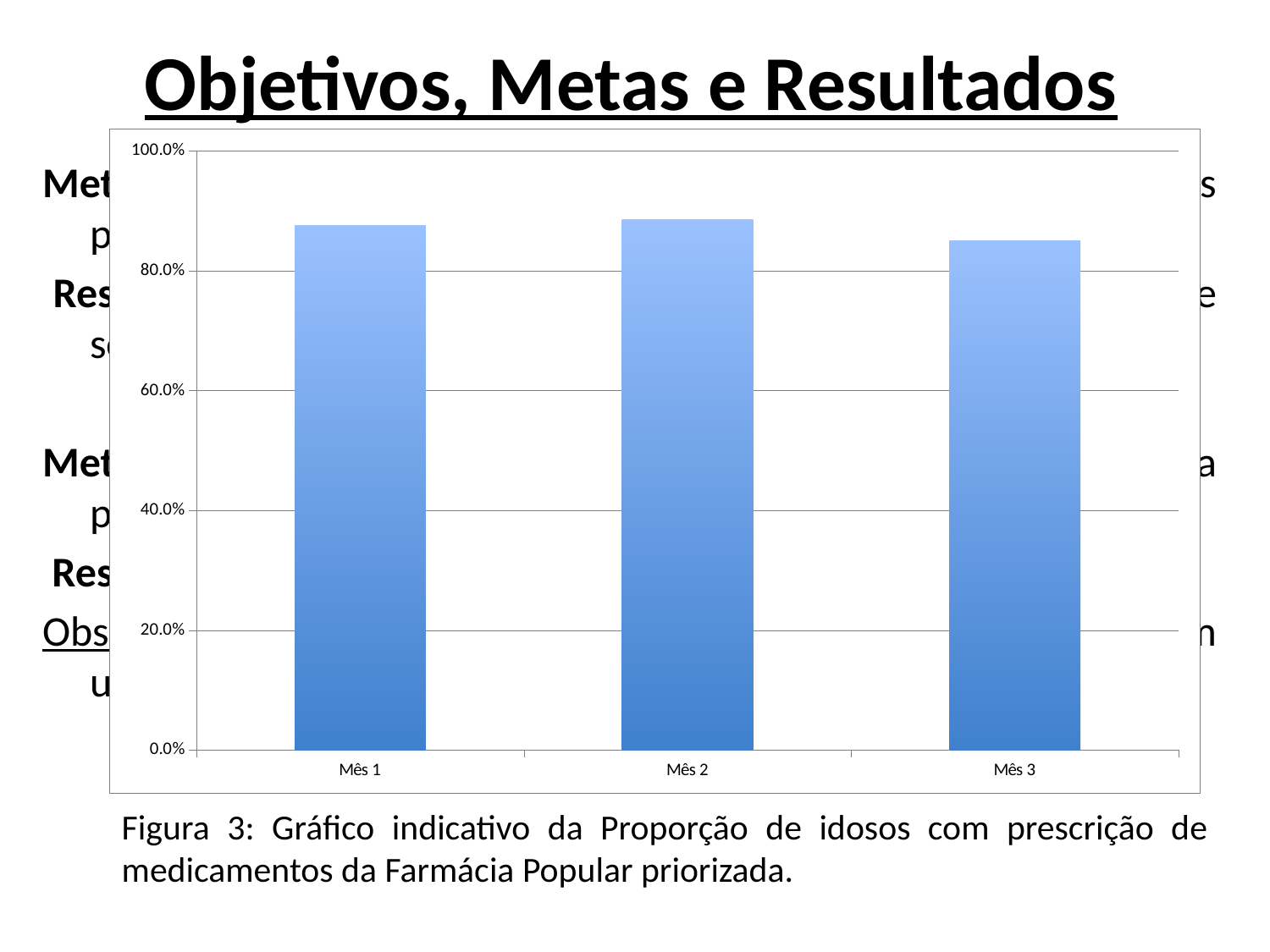
Is the value for Mês 2 greater or less than 100.0%? less How many categories (months) are plotted on the chart? 3 Which is larger, the value for Mês 2 or the value for Mês 3? Mês 2 What is the highest value shown on the y axis of the chart? 100.0% Is the value for Mês 2 greater or less than 80.0%? greater Is the value for Mês 1 greater or less than 80.0%? greater What kind of chart is shown on the slide? bar chart What is the label of the first category on the x axis? Mês 1 Which month has the lowest value on the chart? Mês 3